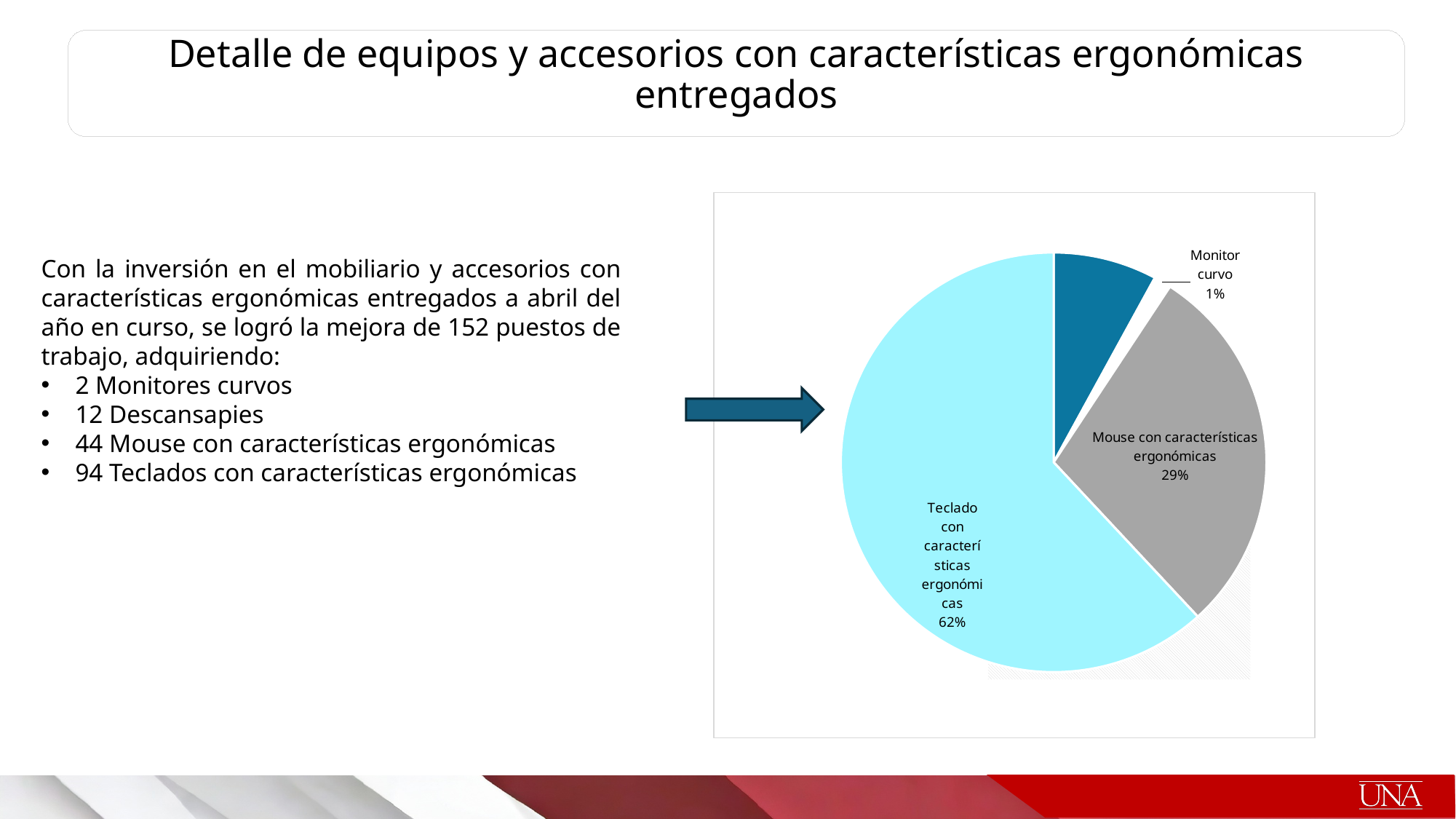
What kind of chart is shown on the slide? Pie chart What percentage is shown for Mouse con características ergonómicas? 29% What percentage is shown for Monitor curvo? 1% What colour is the Teclado con características ergonómicas slice? Light blue Which labelled slice of the pie chart is the smallest? Monitor curvo What share of the pie does Teclado con características ergonómicas represent? 62% What is the difference in percentage points between the Teclado con características ergonómicas slice and the Mouse con características ergonómicas slice? 33 Which is larger, the Mouse con características ergonómicas slice or the Monitor curvo slice? Mouse con características ergonómicas Which labelled slice of the pie chart is the largest? Teclado con características ergonómicas What colour is the Mouse con características ergonómicas slice? Grey How many slices does the pie chart have? 4